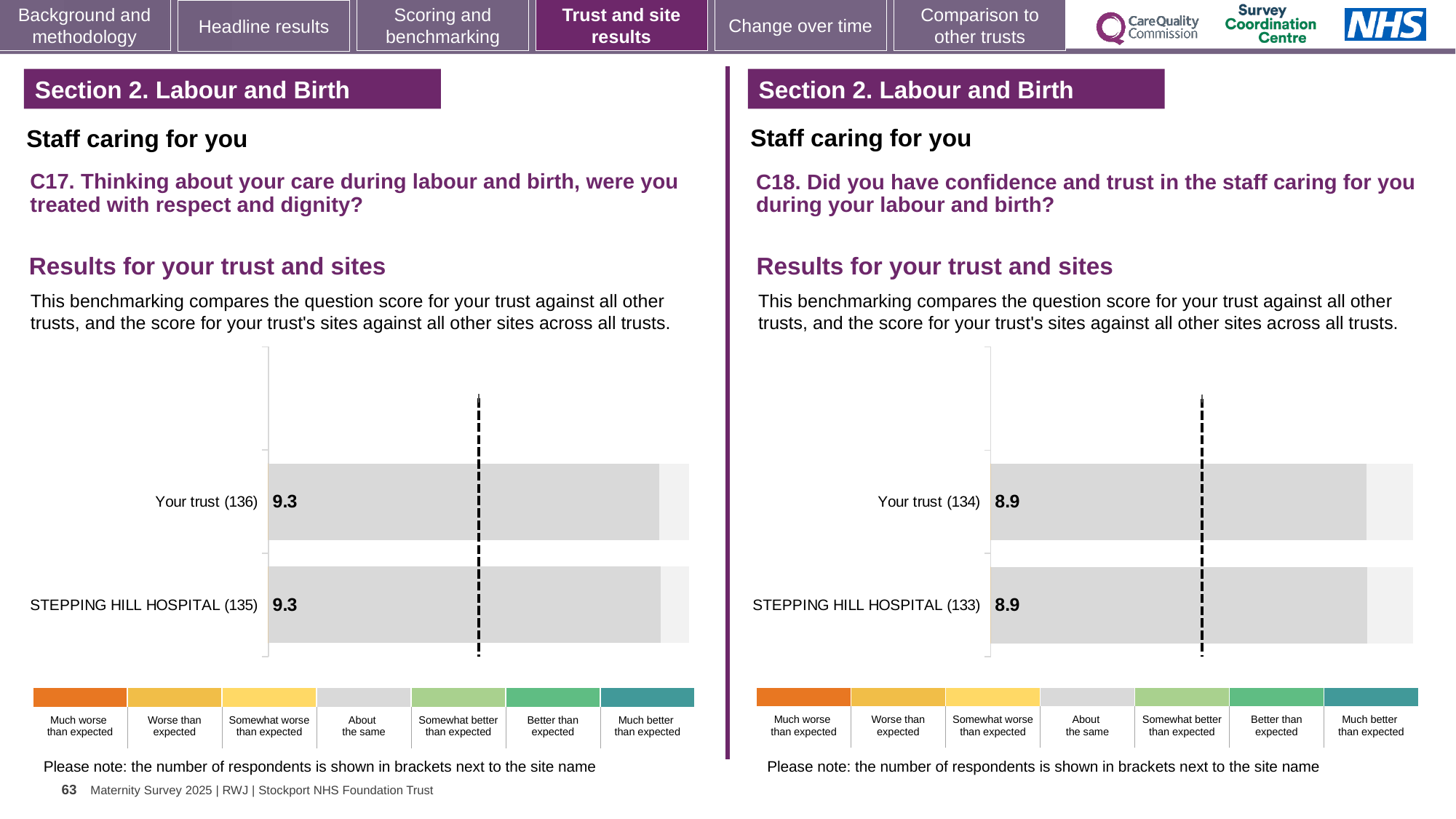
How many benchmark categories does the colour key below the C17 chart on the left list? 7 In the C18 chart on the right, how many respondents are shown in brackets for Your trust? 134 In the C17 chart on the left, what is the difference between the Your trust score and the STEPPING HILL HOSPITAL score? 0 In the C17 chart on the left, what is the score for Your trust? 9.3 In the C18 chart on the right, what is the score for STEPPING HILL HOSPITAL? 8.9 In the C18 chart on the right, what is the score for Your trust? 8.9 How many bars are plotted in the C17 chart on the left? 2 What kind of chart is used for the C17 results on the left? Bar chart What is the difference between the Your trust score in the C17 chart and the Your trust score in the C18 chart? 0.4 How many bars are plotted in the C18 chart on the right? 2 In the C17 chart on the left, what is the score for STEPPING HILL HOSPITAL? 9.3